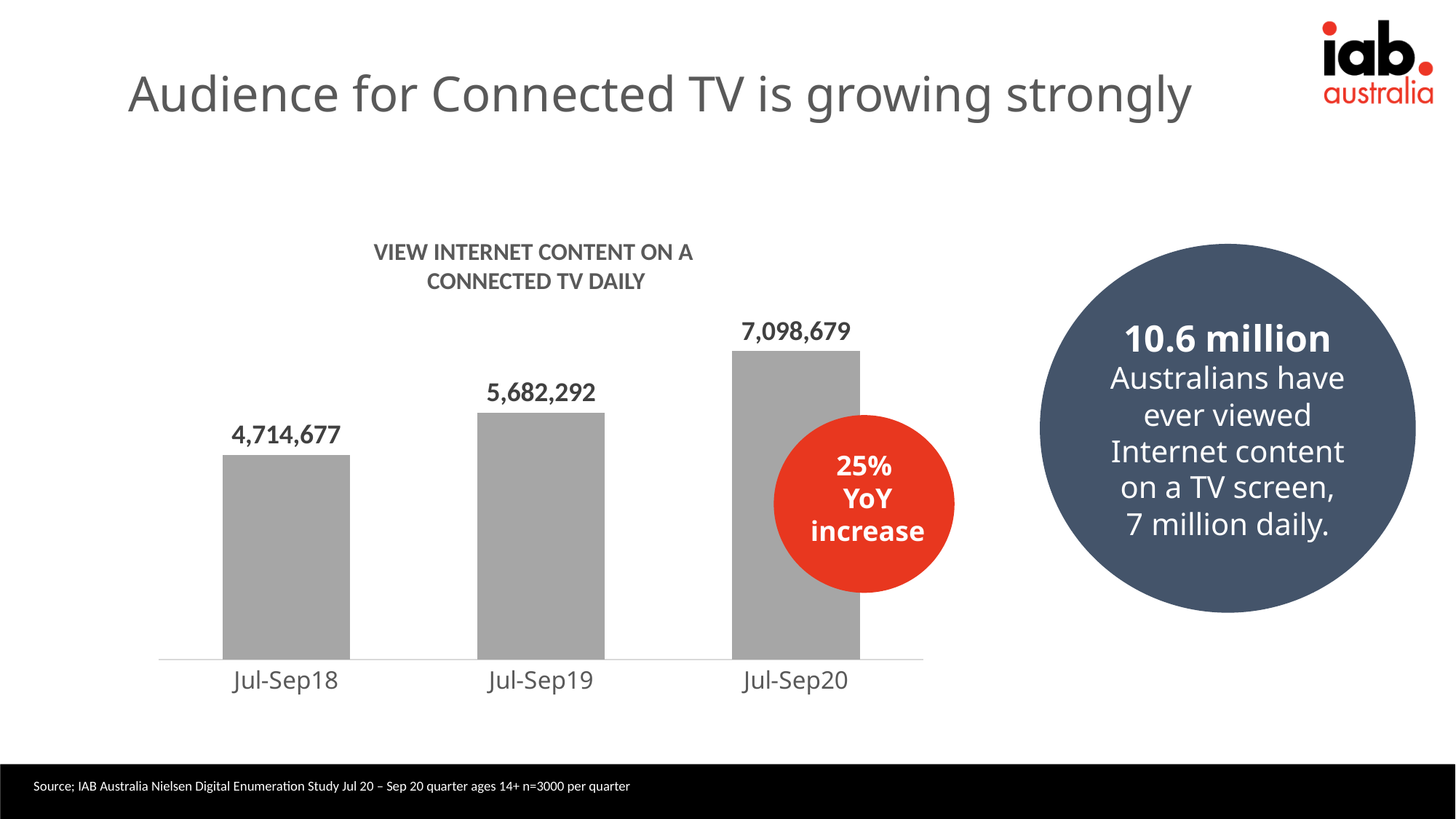
What kind of chart is shown on the slide? Bar chart Which is larger, the value for Jul-Sep19 or the value for Jul-Sep18? Jul-Sep19 What is the value for Jul-Sep19? 5,682,292 What is the value for Jul-Sep18? 4,714,677 How many periods are shown on the chart? 3 Do the values rise or fall from Jul-Sep18 to Jul-Sep20? Rise Which period has the highest value? Jul-Sep20 What is the difference between the values for Jul-Sep20 and Jul-Sep18? 2,384,002 What is the difference between the values for Jul-Sep19 and Jul-Sep18? 967,615 What is the value for Jul-Sep20? 7,098,679 Which period has the lowest value? Jul-Sep18 What is the difference between the values for Jul-Sep20 and Jul-Sep19? 1,416,387